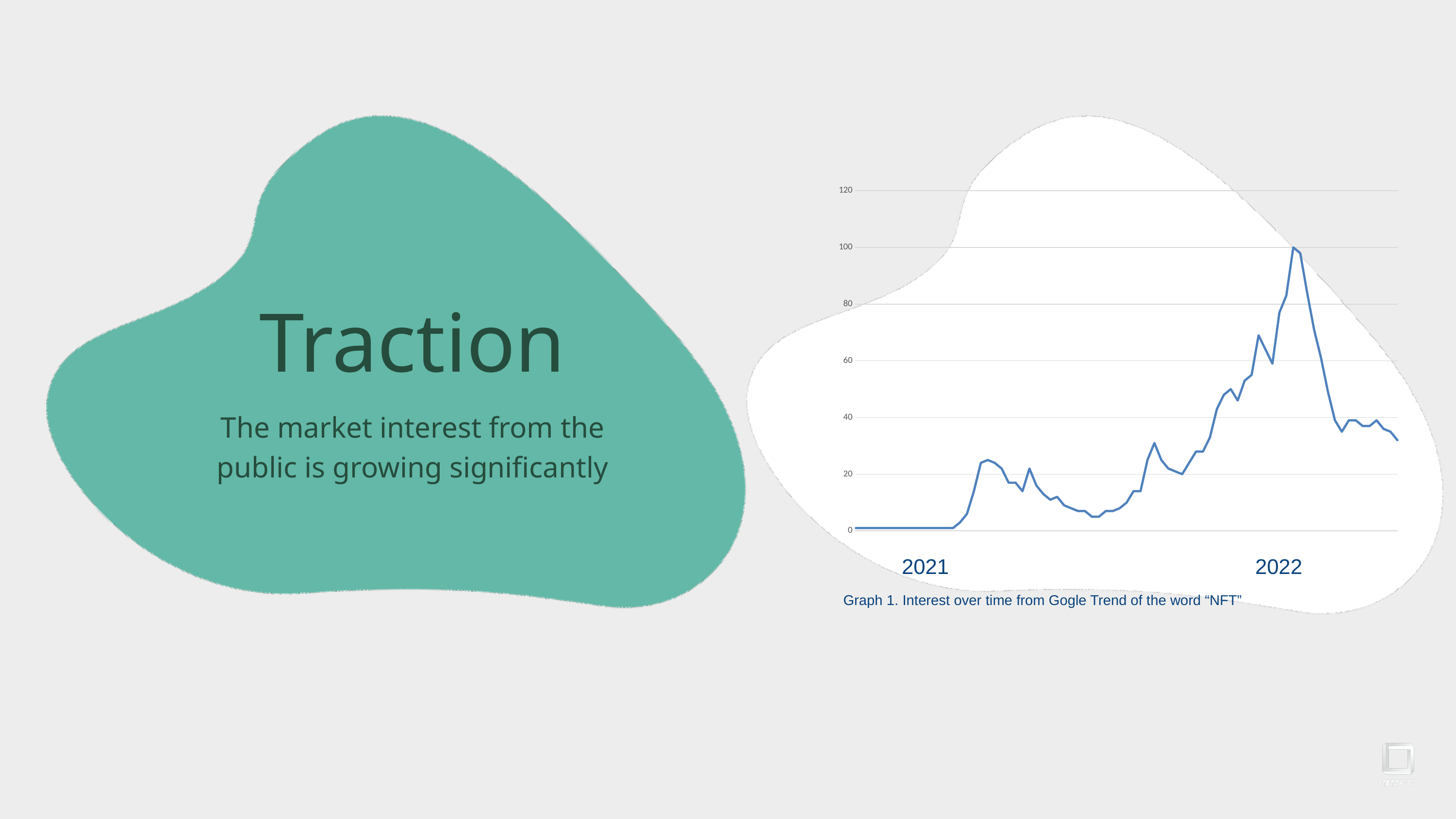
What is the highest value shown on the y axis of the chart? 120 Which two year labels appear on the x axis of the chart? 2021 and 2022 What kind of chart is shown on the slide? line chart How many lines are plotted on the chart? 1 What is the caption printed below the chart? Graph 1. Interest over time from Gogle Trend of the word "NFT" Is the value of the line at the 2022 label greater or less than 60? greater Overall, does the line rise or fall from the 2021 label to the 2022 label? rise Is the value of the line at the start of 2021 greater or less than 20? less Is the value of the line at the right end of the chart greater or less than 40? less After reaching its peak, does the line rise or fall toward the right end of the chart? fall Does the peak of the line occur before or after the 2022 label? after